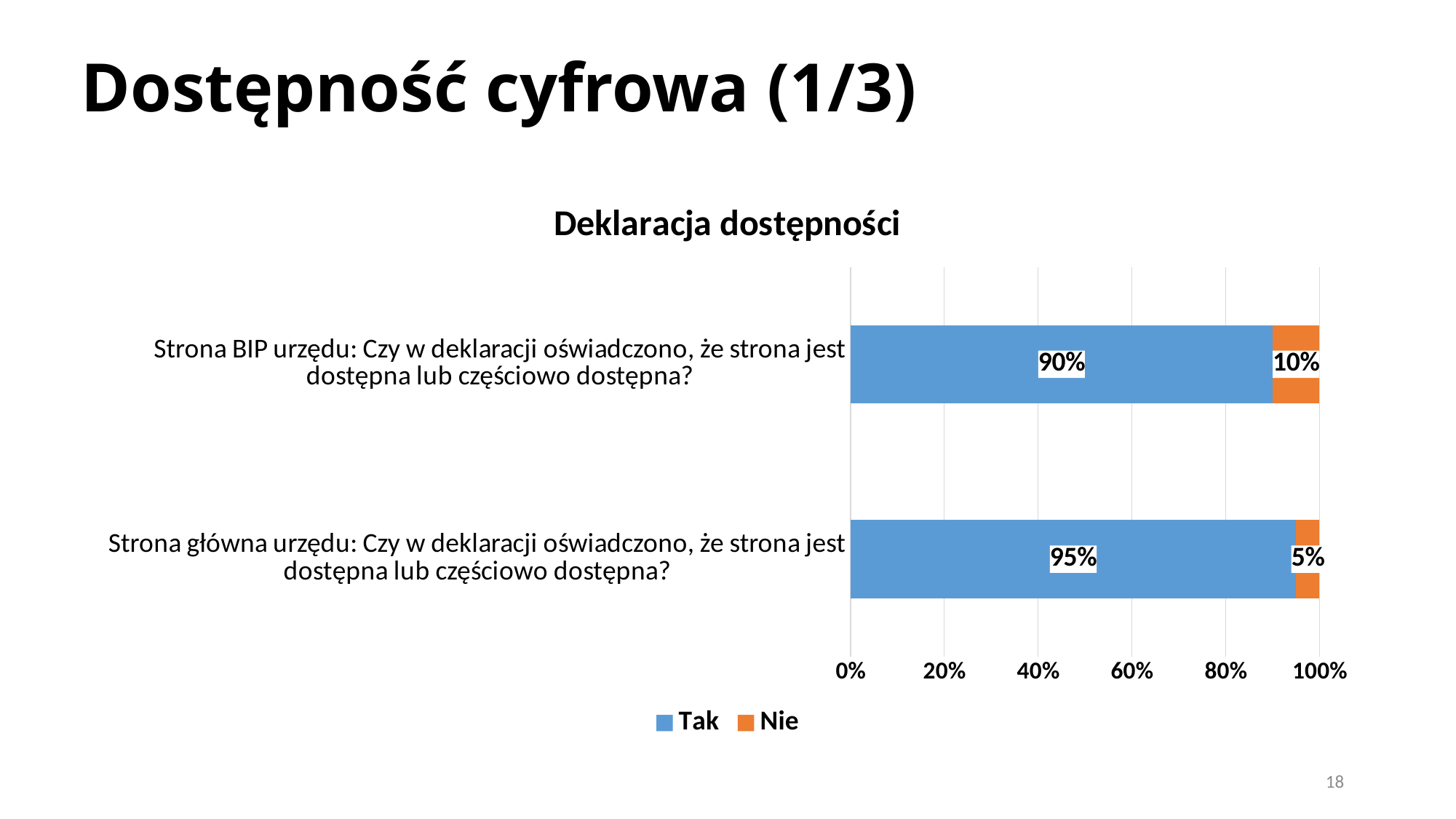
What kind of chart is shown on the slide? Stacked bar chart How many categories are shown in the chart? 2 Which category has the lower 'Nie' value? Strona główna urzędu: Czy w deklaracji oświadczono, że strona jest dostępna lub częściowo dostępna? What is the 'Nie' value for 'Strona BIP urzędu: Czy w deklaracji oświadczono, że strona jest dostępna lub częściowo dostępna?'? 10% What is the 'Nie' value for 'Strona główna urzędu: Czy w deklaracji oświadczono, że strona jest dostępna lub częściowo dostępna?'? 5% What is the title of the chart? Deklaracja dostępności What is the total of the stacked bar for 'Strona BIP urzędu: Czy w deklaracji oświadczono, że strona jest dostępna lub częściowo dostępna?'? 100% What is the 'Tak' value for 'Strona BIP urzędu: Czy w deklaracji oświadczono, że strona jest dostępna lub częściowo dostępna?'? 90% What is the 'Tak' value for 'Strona główna urzędu: Czy w deklaracji oświadczono, że strona jest dostępna lub częściowo dostępna?'? 95% What is the difference between the 'Tak' values for the Strona główna urzędu and Strona BIP urzędu categories? 5% Which category has the higher 'Tak' value? Strona główna urzędu: Czy w deklaracji oświadczono, że strona jest dostępna lub częściowo dostępna? How many series does the legend list? 2